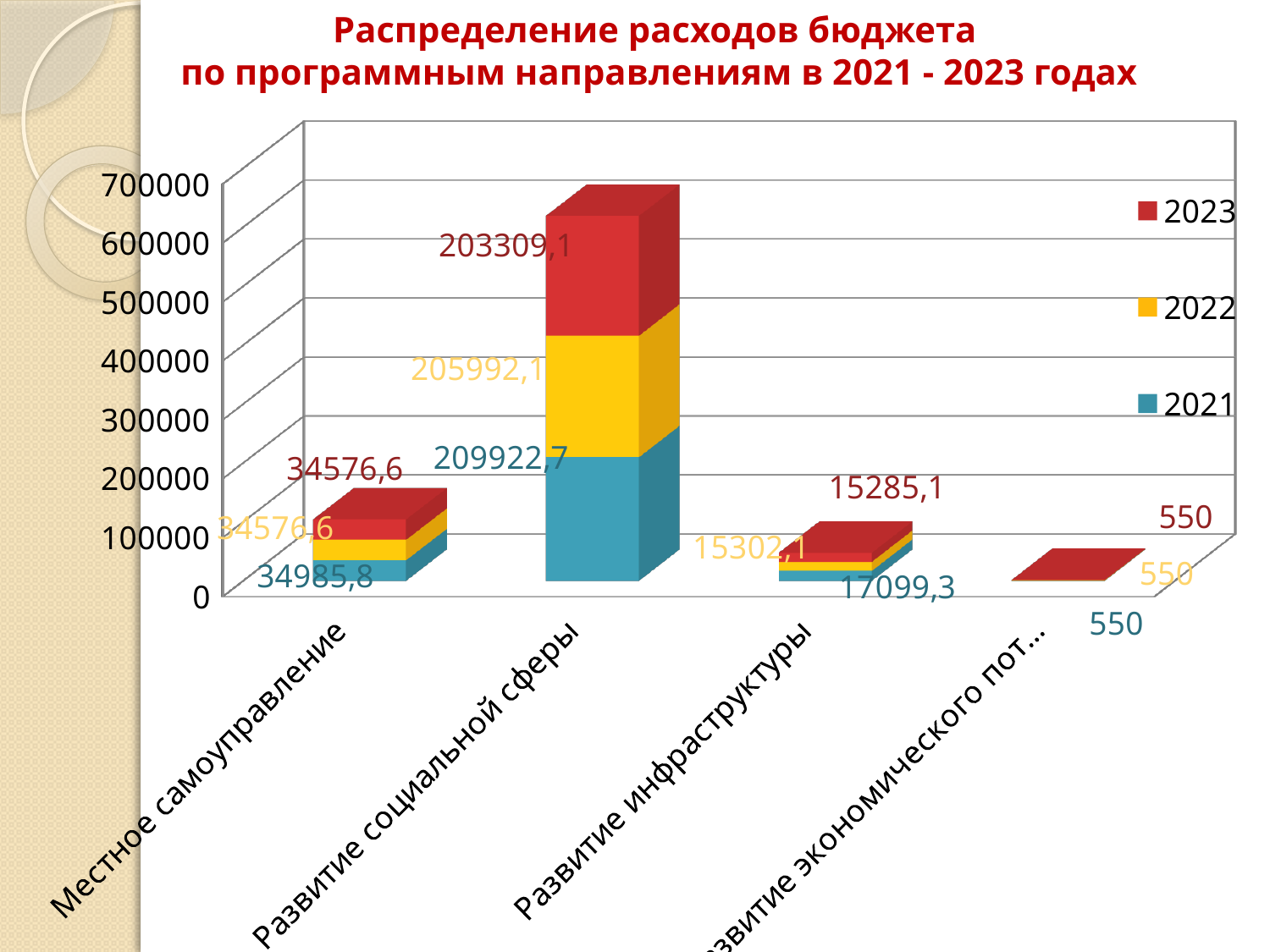
How many series does the legend list? 3 How many categories are shown on the x axis? 4 What is the 2021 value for Развитие социальной сферы? 209922,7 Which category has the highest total expenditure across the three years? Развитие социальной сферы What is the difference between the 2021 and 2023 values for Развитие социальной сферы? 6613,6 Which year is shown in red in the legend? 2023 What kind of chart is shown on the slide? Stacked bar chart Which is larger: the 2021 value for Развитие инфраструктуры or the 2021 value for Местное самоуправление? Местное самоуправление Which category has the lowest total expenditure across the three years? The fourth category (Развитие экономического пот…) What is the 2022 value for Развитие инфраструктуры? 15302,1 What is the total of the stacked bar for Развитие инфраструктуры? 47686,5 What is the 2023 value for Местное самоуправление? 34576,6